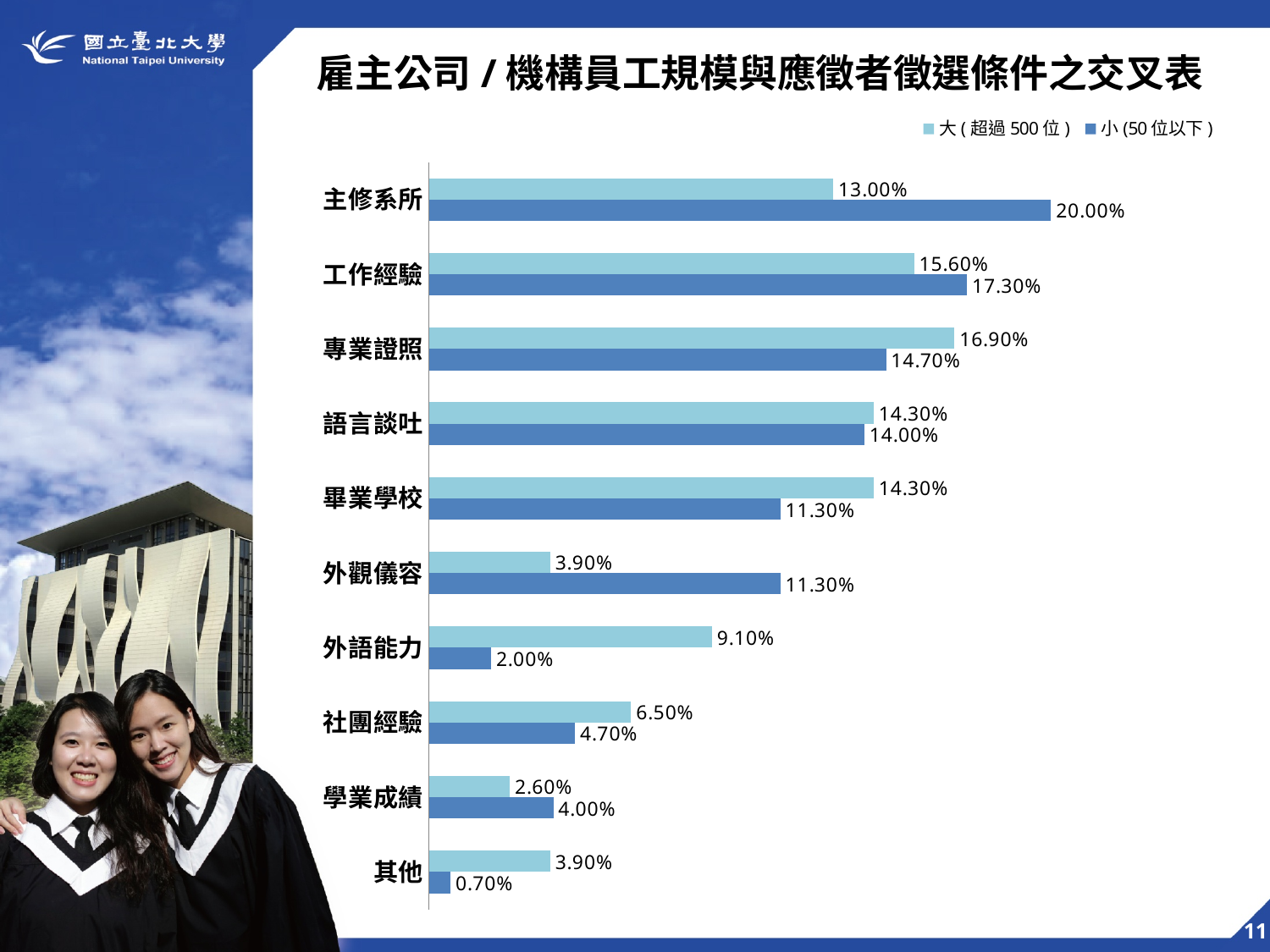
How many series does the legend list? 2 How many categories are shown on the chart? 10 What is the value for 外語能力 in the 小 (50 位以下) series? 2.00% What is the difference between the 小 (50 位以下) and 大 (超過 500 位) values for 主修系所? 7.00% Which category has the highest value in the 大 (超過 500 位) series? 專業證照 Which category has the lowest value in the 小 (50 位以下) series? 其他 What kind of chart is shown on the slide? Bar chart What is the difference between the 大 (超過 500 位) and 小 (50 位以下) values for 外語能力? 7.10% What is the value for 主修系所 in the 小 (50 位以下) series? 20.00% What is the value for 專業證照 in the 大 (超過 500 位) series? 16.90% For 畢業學校, which series has the larger value, 大 (超過 500 位) or 小 (50 位以下)? 大 (超過 500 位) For 外觀儀容, which series has the larger value, 大 (超過 500 位) or 小 (50 位以下)? 小 (50 位以下)